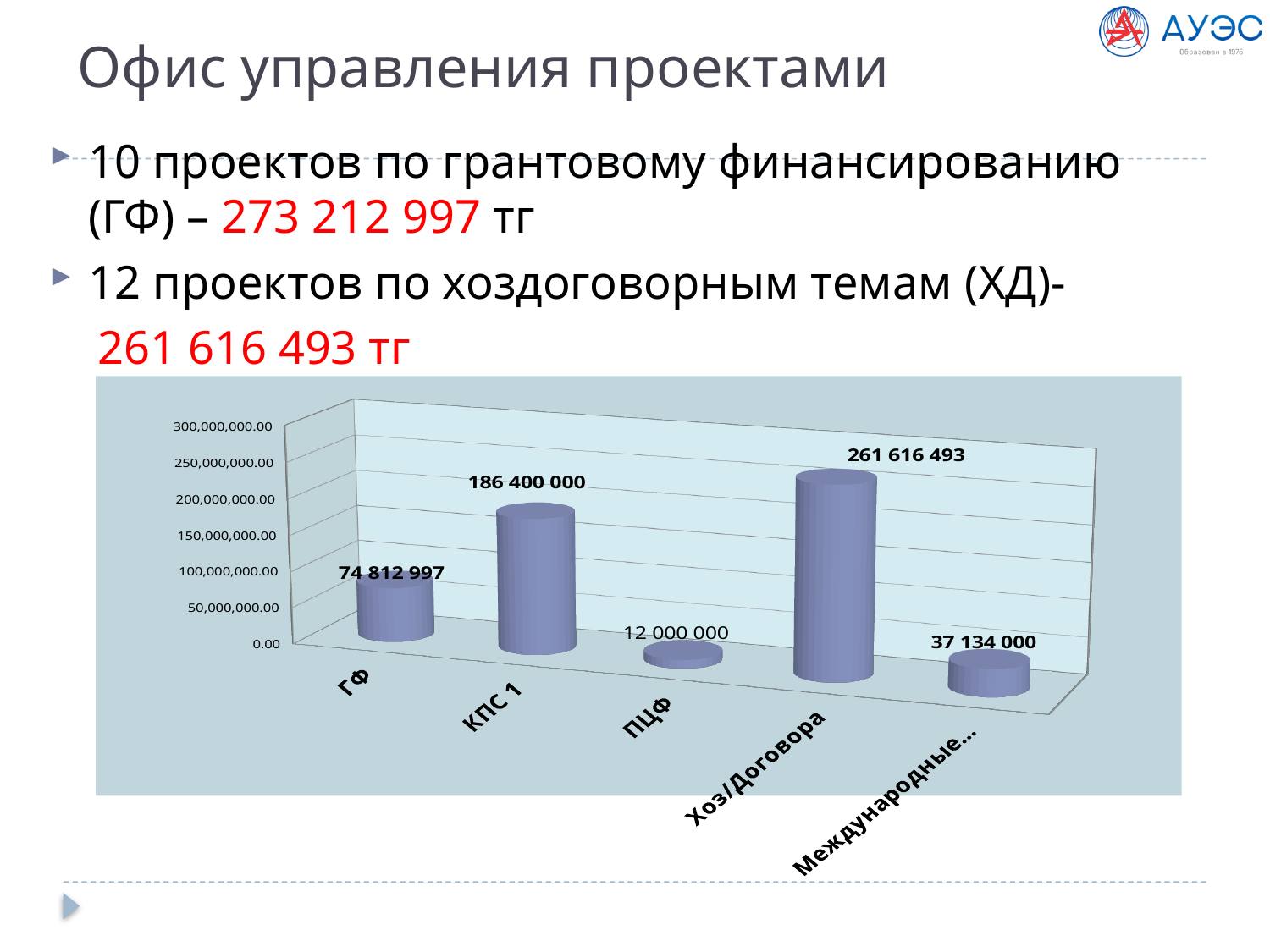
Is the value for КПС 1 greater or less than 150,000,000.00? greater How many categories are shown on the x axis of the chart? 5 What kind of chart is shown on the slide? bar chart What is the value for ГФ in the chart? 74 812 997 What is the value for КПС 1 in the chart? 186 400 000 What is the value for ПЦФ in the chart? 12 000 000 Which is larger, the value for ГФ or the value for ПЦФ? ГФ Which category has the lowest value in the chart? ПЦФ What is the difference between the values for Хоз/Договора and КПС 1? 75 216 493 Which category has the highest value in the chart? Хоз/Договора What is the difference between the values for КПС 1 and ГФ? 111 587 003 What is the value for Хоз/Договора in the chart? 261 616 493